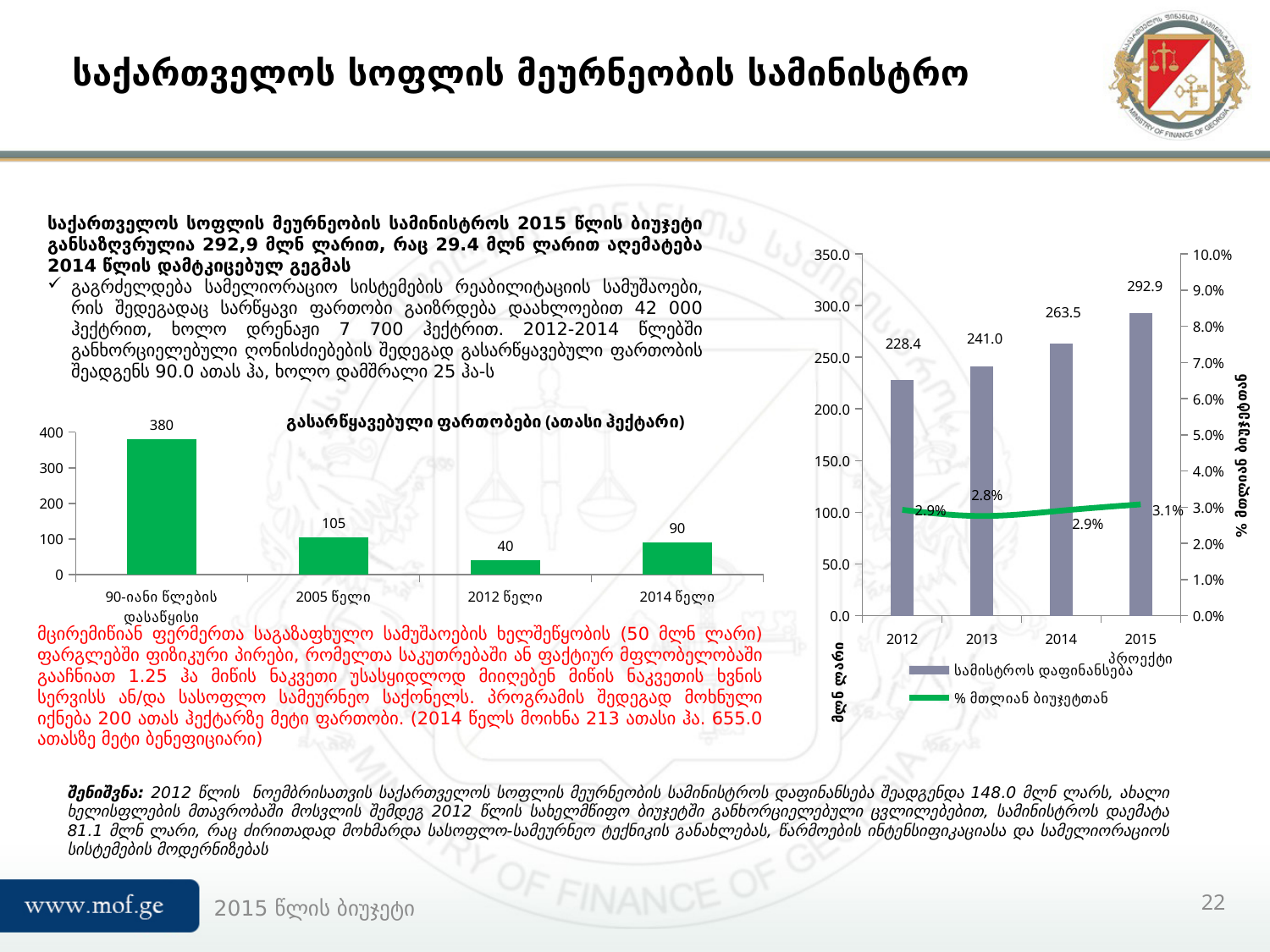
In the right chart, does სამინისტროს დაფინანსება rise or fall from 2012 to 2015 პროექტი? rise In the right chart, what is the value of % მთლიან ბიუჯეტთან for 2013? 2.8% In the left chart (გასარწყავებული ფართობები), what is the difference between the values for 2014 წელი and 2012 წელი? 50 In the left chart (გასარწყავებული ფართობები), how many categories are shown? 4 In the left chart (გასარწყავებული ფართობები), which category has the highest value? 90-იანი წლების დასაწყისი In the left chart (გასარწყავებული ფართობები), which category has the lowest value? 2012 წელი What kind of chart is the left chart (გასარწყავებული ფართობები)? bar chart In the right chart, what is the difference between სამინისტროს დაფინანსება for 2015 პროექტი and 2012? 64.5 In the right chart, what is the value of სამინისტროს დაფინანსება for 2014? 263.5 In the right chart, how many series does the legend list? 2 In the right chart, which year has the highest value of % მთლიან ბიუჯეტთან? 2015 პროექტი In the left chart (გასარწყავებული ფართობები), what is the value for 2005 წელი? 105